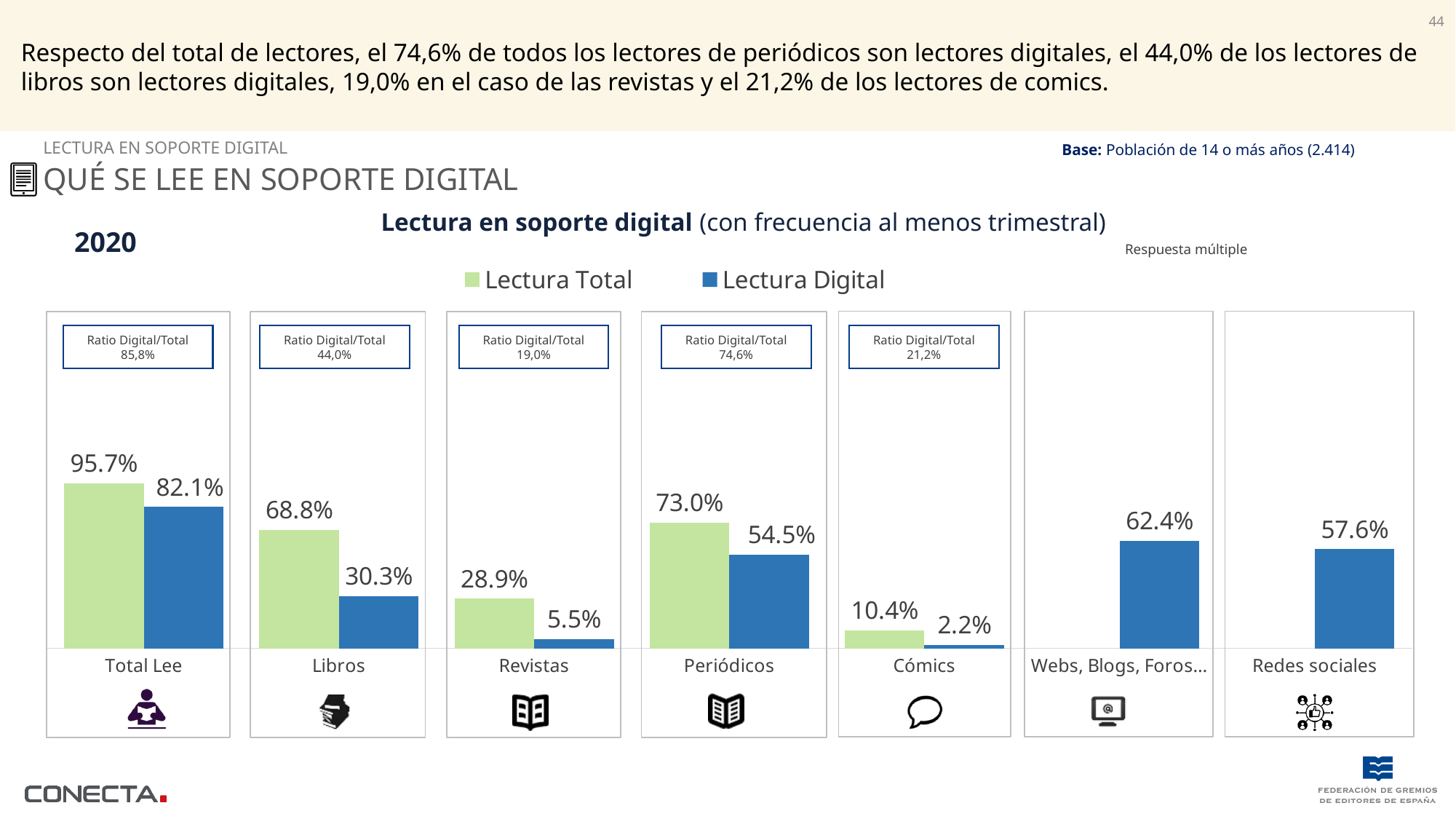
Which is larger: the Lectura Digital value for Webs, Blogs, Foros... or for Redes sociales? Webs, Blogs, Foros... What is the Lectura Digital value for Libros? 30.3% Which category has the highest Lectura Total value? Total Lee What is the Lectura Total value for Periódicos? 73.0% How many series does the legend list? 2 What is the Lectura Total value for Revistas? 28.9% What is the difference between Lectura Total and Lectura Digital for Periódicos? 18.5 percentage points What is the difference between Lectura Total and Lectura Digital for Libros? 38.5 percentage points Which category has the lowest Lectura Digital value? Cómics How many categories are shown on the x axis of the chart? 7 What is the Lectura Digital value for Redes sociales? 57.6% What kind of chart is shown on the slide? Bar chart